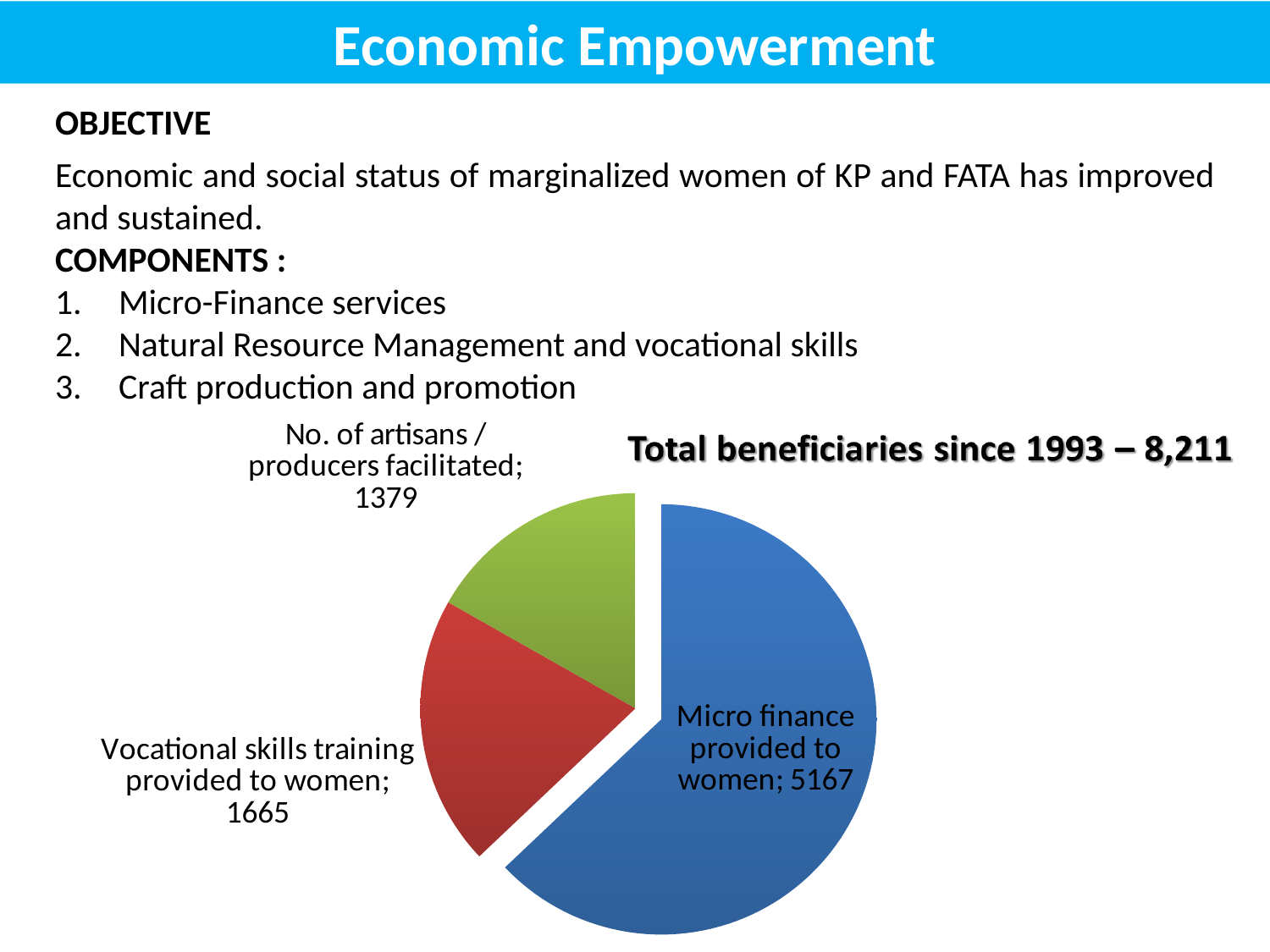
Which is larger: Vocational skills training provided to women or No. of artisans / producers facilitated? Vocational skills training provided to women Which category has the largest slice of the pie? Micro finance provided to women What is the value for No. of artisans / producers facilitated? 1379 What is the value for Micro finance provided to women? 5167 What colour is the slice for Micro finance provided to women? blue What is the value for Vocational skills training provided to women? 1665 What kind of chart is shown on the slide? pie chart What is the total of all three slices in the pie chart? 8211 What is the difference between the value for Micro finance provided to women and the value for Vocational skills training provided to women? 3502 Which category has the smallest slice of the pie? No. of artisans / producers facilitated What is the difference between the value for Vocational skills training provided to women and the value for No. of artisans / producers facilitated? 286 How many slices does the pie chart have? 3